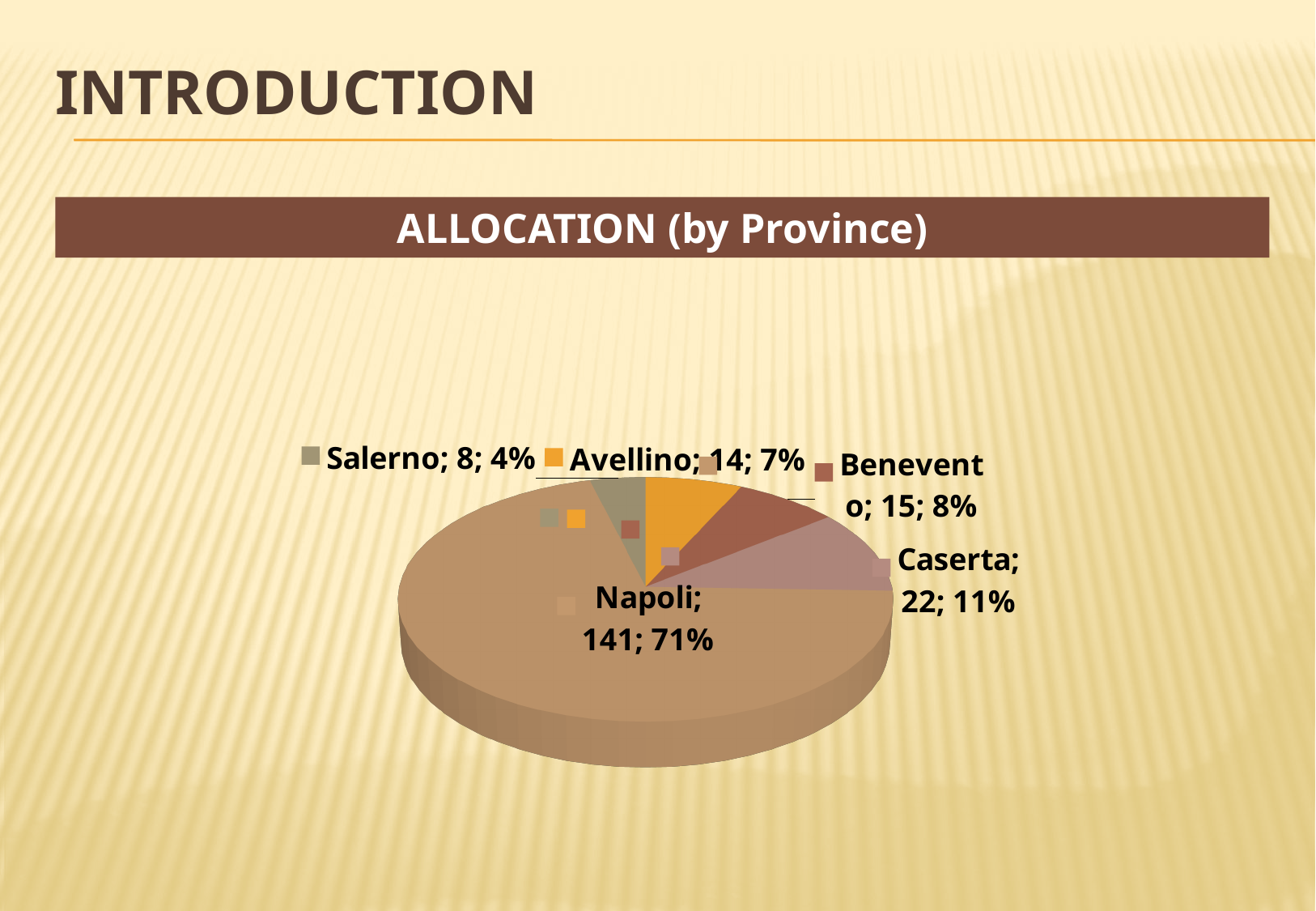
What is the value for Napoli? 141 How many provinces are shown in the pie chart? 5 What is the value for Benevento? 15 What percentage share does Napoli have? 71% Which province has the largest slice? Napoli What percentage share does Salerno have? 4% What is the value for Caserta? 22 What is the difference between the values for Caserta and Salerno? 14 Which province has the smallest slice? Salerno What is the value for Avellino? 14 What is the title of the chart? ALLOCATION (by Province) What kind of chart is shown on the slide? pie chart